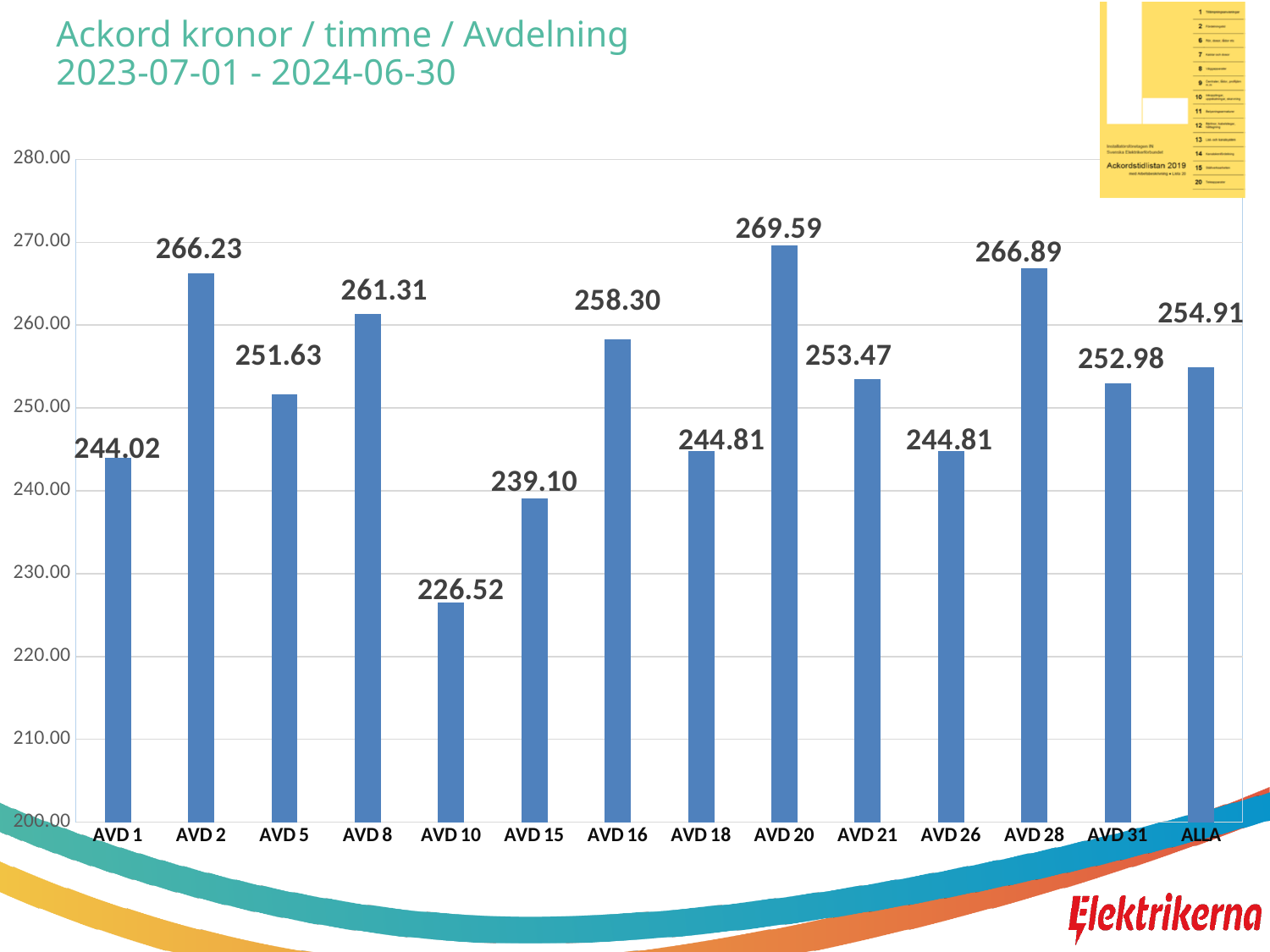
Which is larger, the value for AVD 8 or the value for AVD 16? AVD 8 What is the difference between the values for AVD 20 and AVD 10? 43.07 What is the value for AVD 20? 269.59 Which category has the highest value? AVD 20 What is the value for AVD 10? 226.52 Is the value for AVD 28 greater or less than 260.00? greater What is the value for AVD 15? 239.10 How many categories are shown on the x axis? 14 What kind of chart is shown on the slide? bar chart What is the difference between the values for AVD 2 and AVD 1? 22.21 What is the value for ALLA? 254.91 Which category has the lowest value? AVD 10